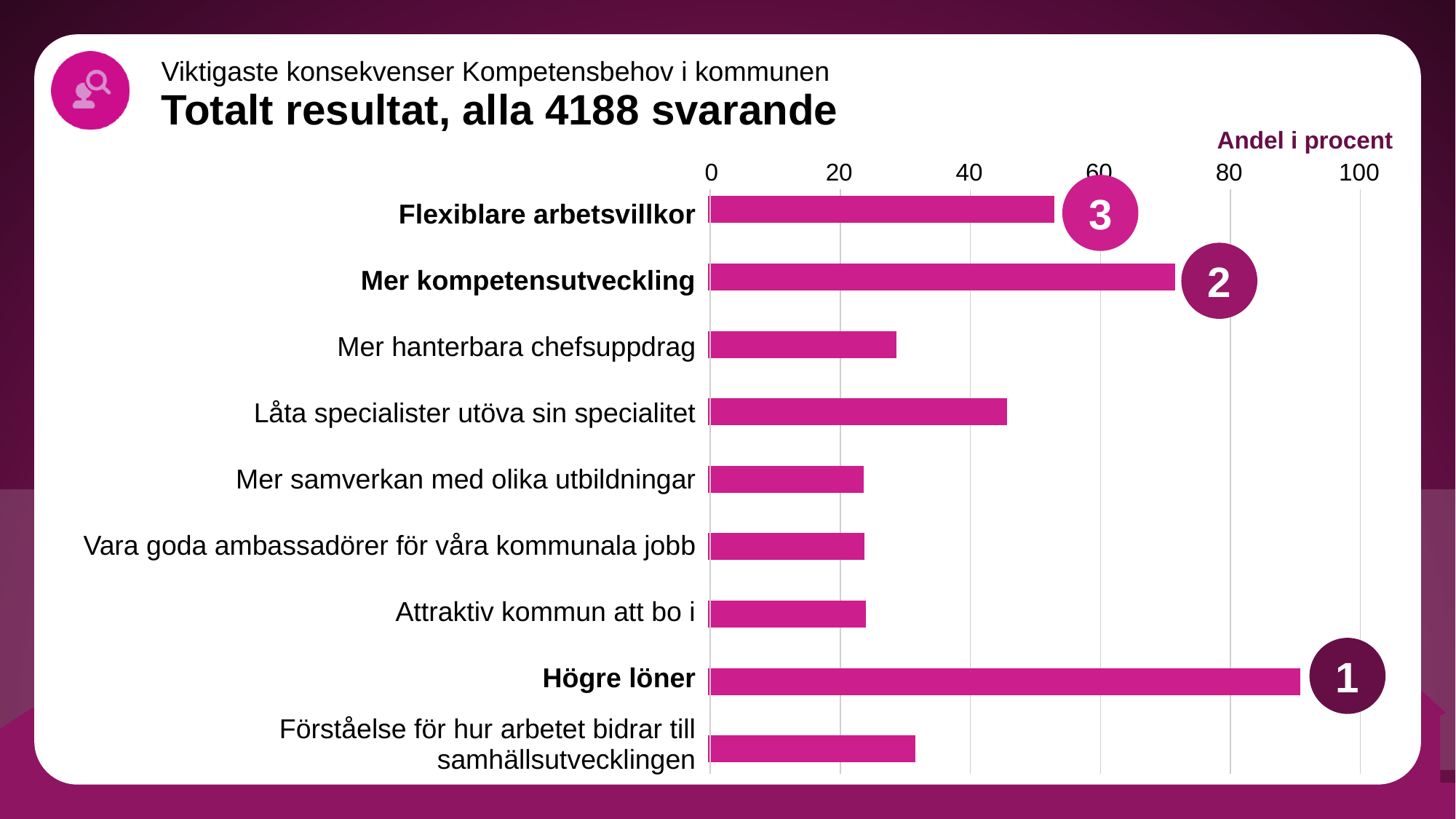
What kind of chart is shown on the slide? bar chart Which category is marked with the circled number 1 in the chart? Högre löner Is the value for Låta specialister utöva sin specialitet greater or less than 40? greater Which is larger, the value for Mer kompetensutveckling or the value for Flexiblare arbetsvillkor? Mer kompetensutveckling What is the label shown above the horizontal axis of the chart? Andel i procent How many categories are plotted in the chart? 9 Is the value for Mer hanterbara chefsuppdrag greater or less than 40? less Which is larger, the value for Förståelse för hur arbetet bidrar till samhällsutvecklingen or the value for Låta specialister utöva sin specialitet? Låta specialister utöva sin specialitet Is the value for Flexiblare arbetsvillkor greater or less than 60? less Which category has the highest value in the chart? Högre löner